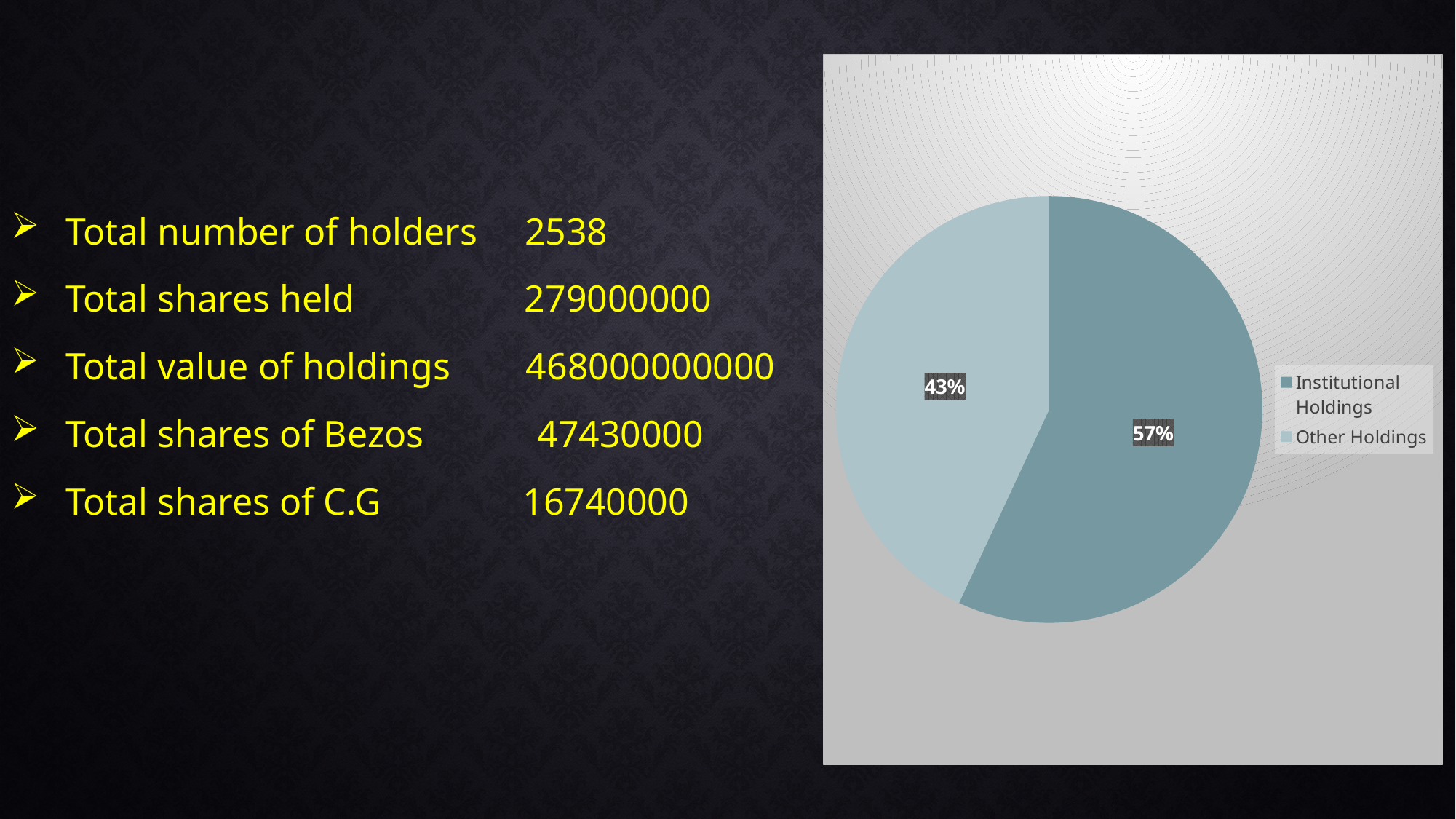
Is the share for Institutional Holdings greater or less than 50%? greater What share of the pie does Institutional Holdings represent? 57% What share of the pie does Other Holdings represent? 43% Which slice of the pie chart is the largest? Institutional Holdings What kind of chart is shown on the slide? pie chart Which legend entry is shown in the lighter blue colour? Other Holdings What is the difference in percentage points between Institutional Holdings and Other Holdings? 14 Which slice of the pie chart is the smallest? Other Holdings How many entries does the legend list? 2 How many slices does the pie chart have? 2 Which is larger, Institutional Holdings or Other Holdings? Institutional Holdings Where is the legend positioned relative to the pie? to the right